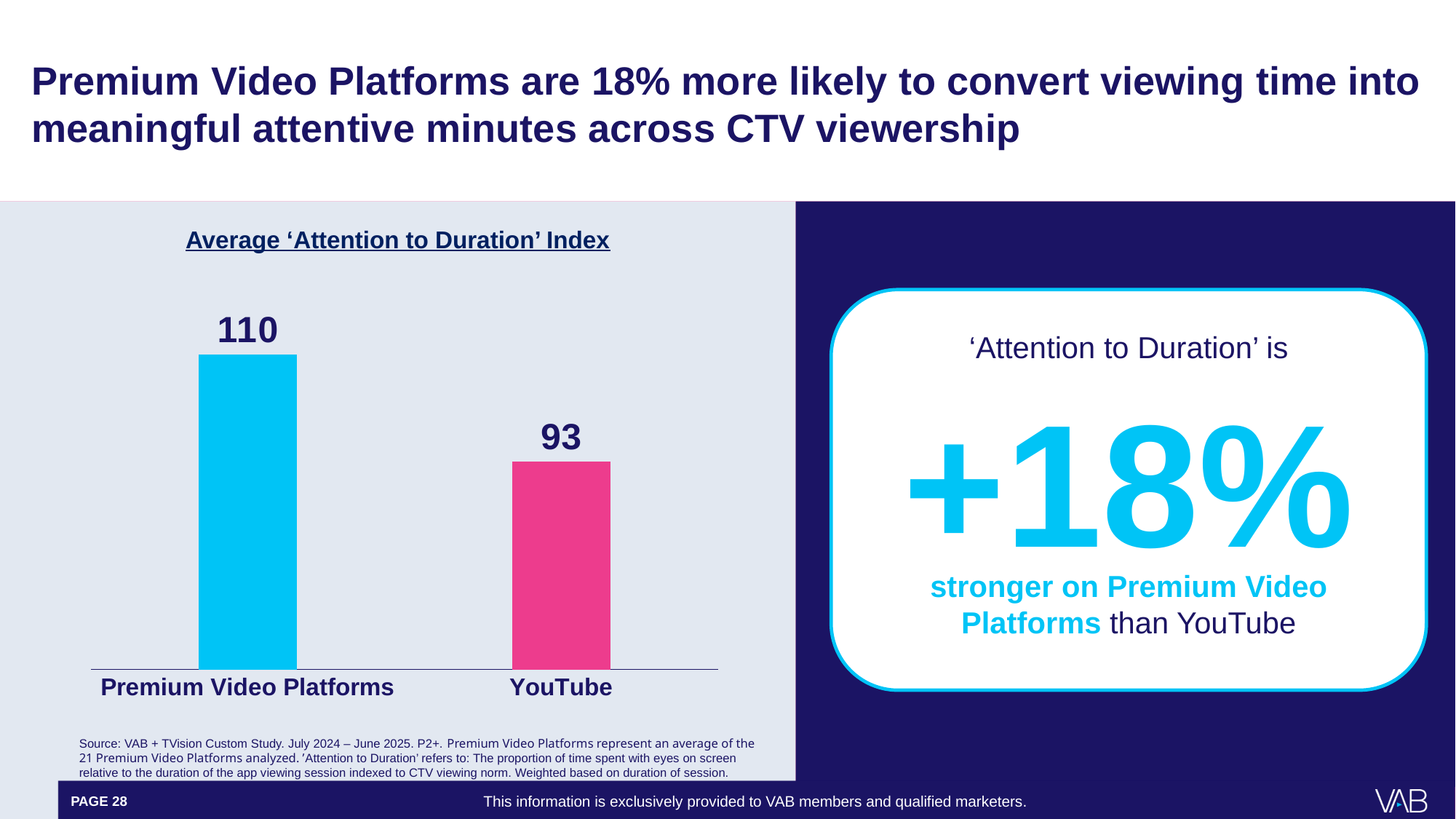
What is the title of the chart? Average 'Attention to Duration' Index What colour is the bar for YouTube? Pink What kind of chart is shown on the slide? Bar chart Which category has the highest Average 'Attention to Duration' Index? Premium Video Platforms What is the Average 'Attention to Duration' Index value for YouTube? 93 What is the difference between the index values for Premium Video Platforms and YouTube? 17 What is the Average 'Attention to Duration' Index value for Premium Video Platforms? 110 How many categories are shown in the chart? 2 Which category has the lowest Average 'Attention to Duration' Index? YouTube Which has a larger Average 'Attention to Duration' Index, Premium Video Platforms or YouTube? Premium Video Platforms